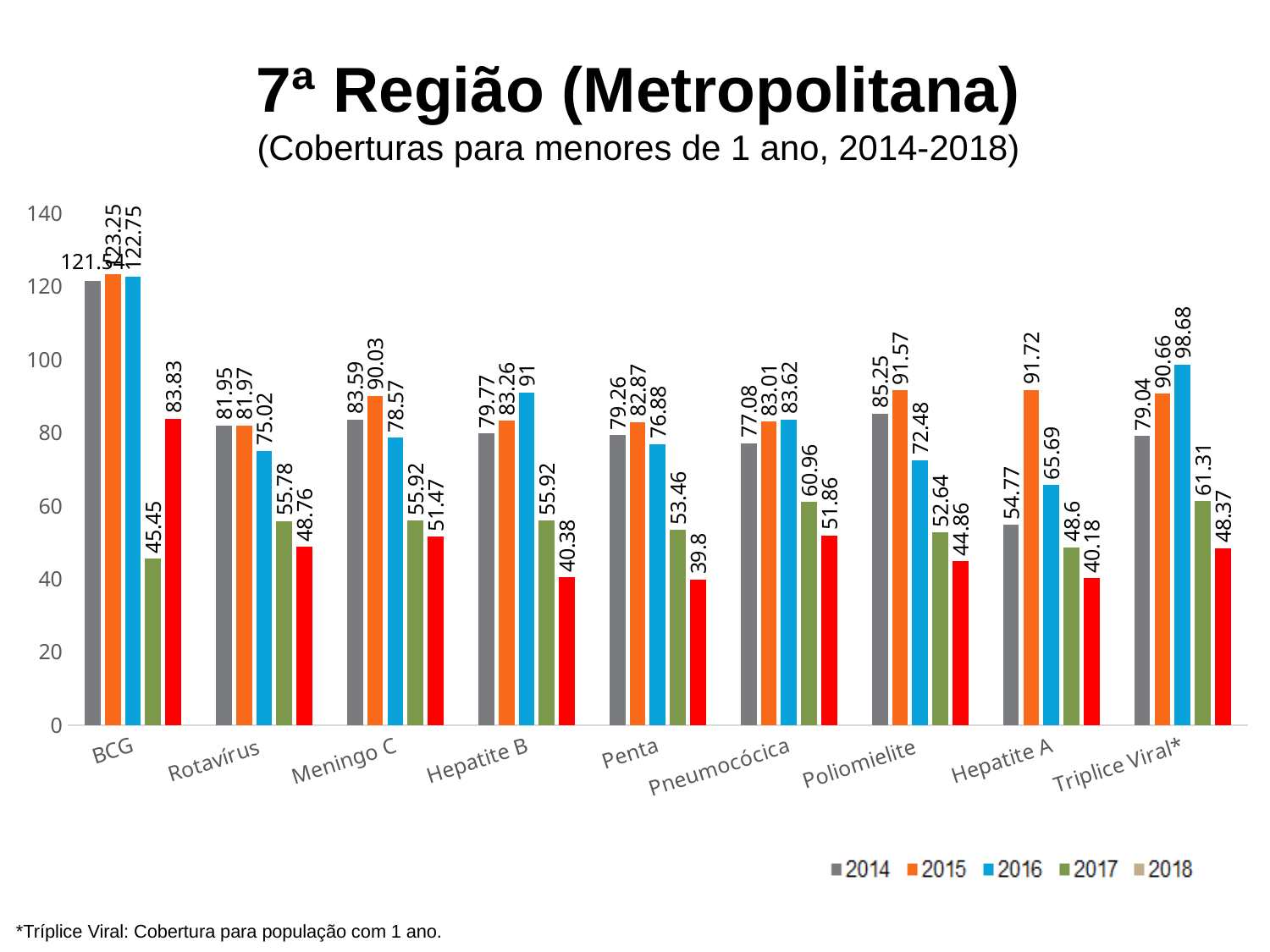
How many series does the legend list? 5 What is the value for Tríplice Viral* in 2016? 98.68 How many vaccine categories are shown on the x axis? 9 What is the difference between the 2015 and 2014 values for Hepatite A? 36.95 What kind of chart is shown on the slide? bar chart Which category has the highest value for 2015? BCG Do the values for Poliomielite rise or fall from 2015 to 2018? fall Which category has the lowest value for 2017? BCG Which is larger for 2016: Poliomielite or Pneumocócica? Pneumocócica What is the 2014 value for Hepatite A? 54.77 What is the 2018 value for Penta? 39.8 Is the 2015 value for BCG greater or less than 120? greater